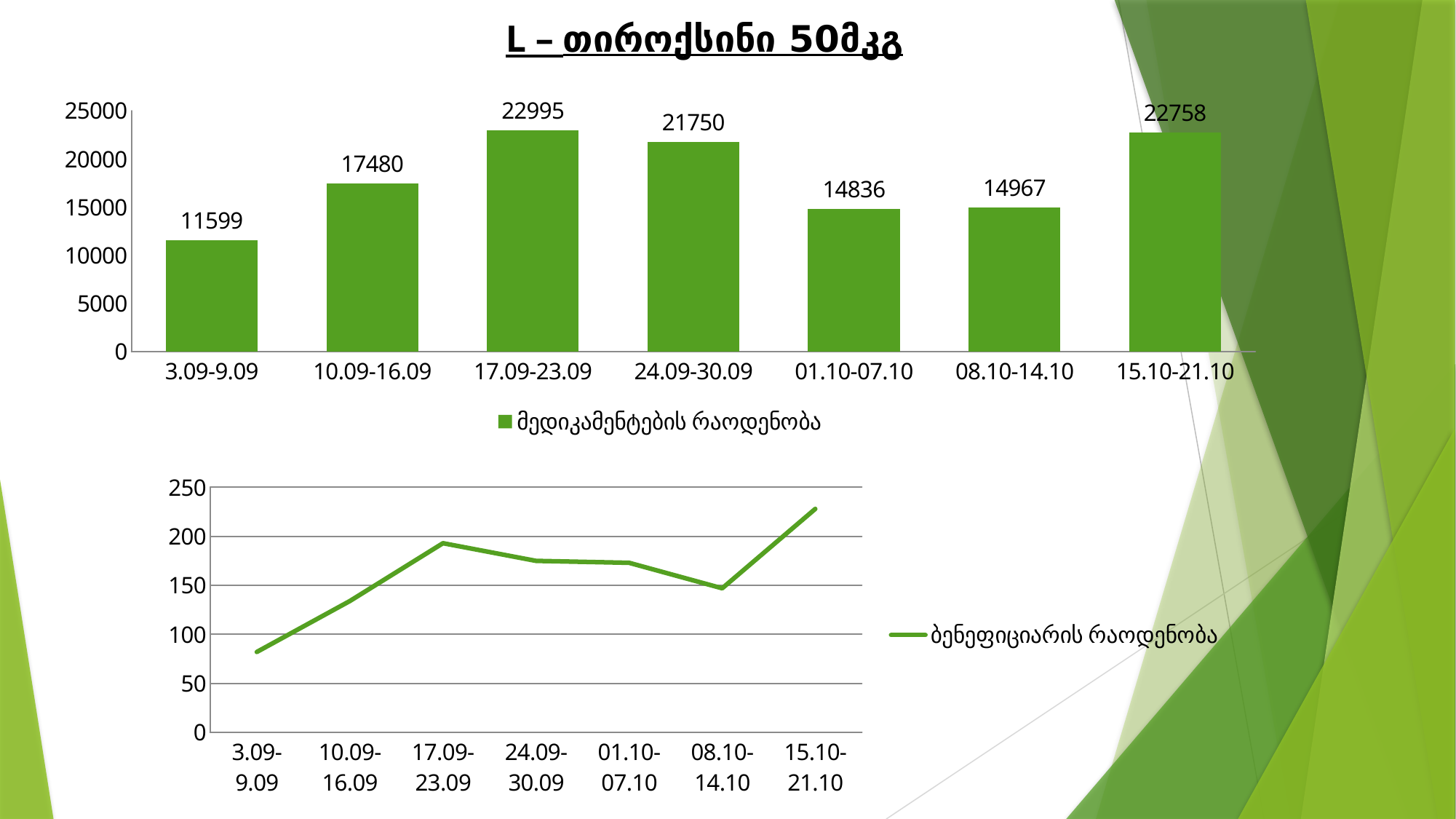
In the top bar chart, what is the value for 17.09-23.09? 22995 In the top bar chart, what is the difference between the values for 17.09-23.09 and 24.09-30.09? 1245 How many bars are in the top bar chart? 7 What is the legend entry of the top bar chart? მედიკამენტების რაოდენობა In the top bar chart, which is larger: the value for 10.09-16.09 or the value for 01.10-07.10? 10.09-16.09 In the top bar chart, which period has the lowest value? 3.09-9.09 In the top bar chart, what is the value for 3.09-9.09? 11599 In the top bar chart, which period has the highest value? 17.09-23.09 In the bottom line chart, is the value for 15.10-21.10 greater or less than 200? greater What kind of chart is the bottom chart on the slide? line chart In the bottom line chart, is the value for 3.09-9.09 greater or less than 100? less In the bottom line chart, which period has the highest value? 15.10-21.10